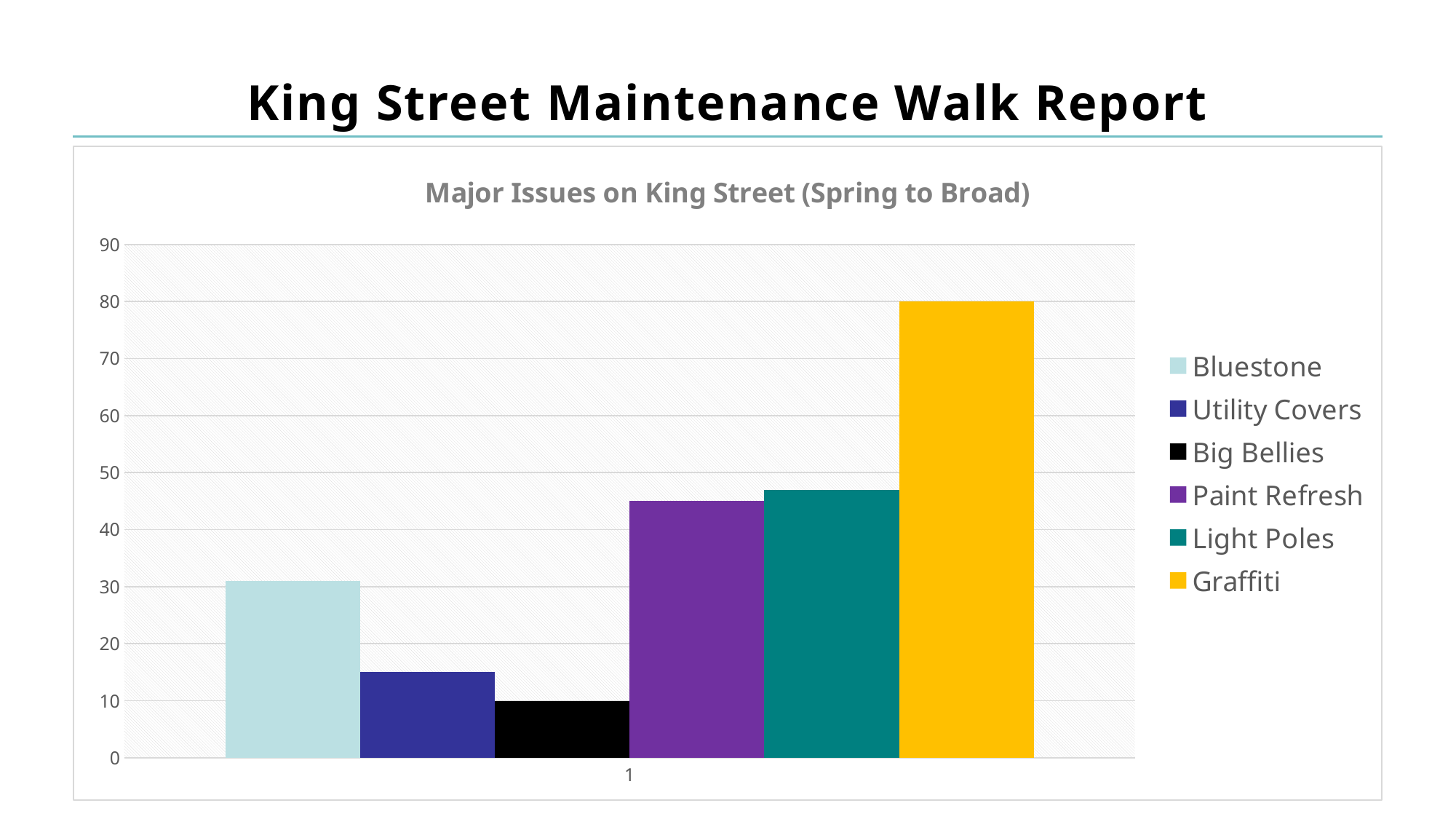
What is the value for Big Bellies? 10 Is the value for Paint Refresh greater or less than 40? greater What is the value for Graffiti? 80 Which series has the lowest value? Big Bellies How many series does the legend list? 6 What kind of chart is shown on the slide? bar chart What is the difference between the values for Graffiti and Big Bellies? 70 Which series has the highest value? Graffiti Is the value for Utility Covers greater or less than 20? less Which is larger, the value for Bluestone or the value for Utility Covers? Bluestone What is the title of the chart? Major Issues on King Street (Spring to Broad)